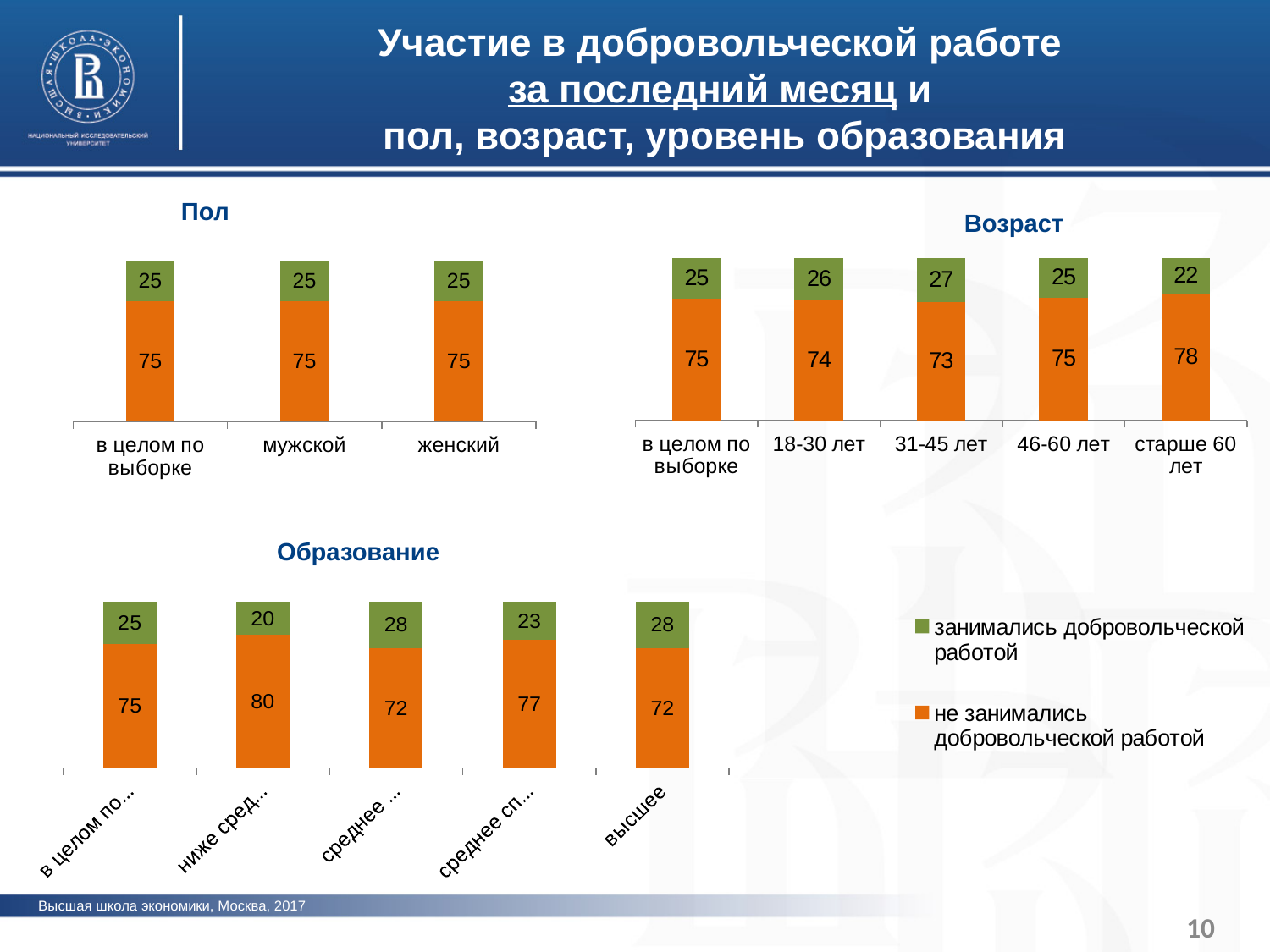
In the 'Образование' chart, what is the value for 'занимались добровольческой работой' for the 'высшее' category? 28 How many categories are shown in the 'Возраст' chart? 5 How many series does the legend list? 2 In the 'Образование' chart, which is larger: the 'не занимались добровольческой работой' value for the second bar from the left or for the 'высшее' bar? the second bar from the left (80) In the 'Возраст' chart, which category has the lowest value for 'занимались добровольческой работой'? старше 60 лет What type of chart is the 'Пол' chart? stacked bar chart In the 'Возраст' chart, what is the value for 'занимались добровольческой работой' for the 'старше 60 лет' category? 22 In the 'Пол' chart, what is the total of the stacked bar for 'мужской'? 100 In the 'Возраст' chart, which age category has the highest value for 'занимались добровольческой работой'? 31-45 лет In the 'Возраст' chart, what is the value for 'не занимались добровольческой работой' for the '31-45 лет' category? 73 In the 'Пол' chart, what is the value for 'не занимались добровольческой работой' for the 'женский' category? 75 In the 'Возраст' chart, what is the difference between the 'не занимались добровольческой работой' values for 'старше 60 лет' and '31-45 лет'? 5